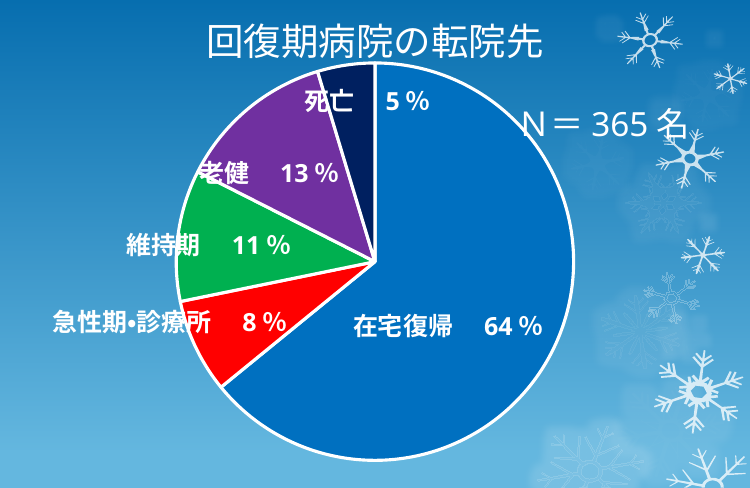
Which category has the smallest share of the pie? 死亡 What is the difference between the values for 老健 and 維持期? 2 % What is the value for 在宅復帰? 64 % Which is larger, the value for 急性期•診療所 or the value for 死亡? 急性期•診療所 How many slices does the pie chart have? 5 What is the value for 死亡? 5 % What is the value for 急性期•診療所? 8 % What is the value for 維持期? 11 % What is the title of the chart? 回復期病院の転院先 What kind of chart is shown on the slide? pie chart Which category has the largest share of the pie? 在宅復帰 What is the value for 老健? 13 %